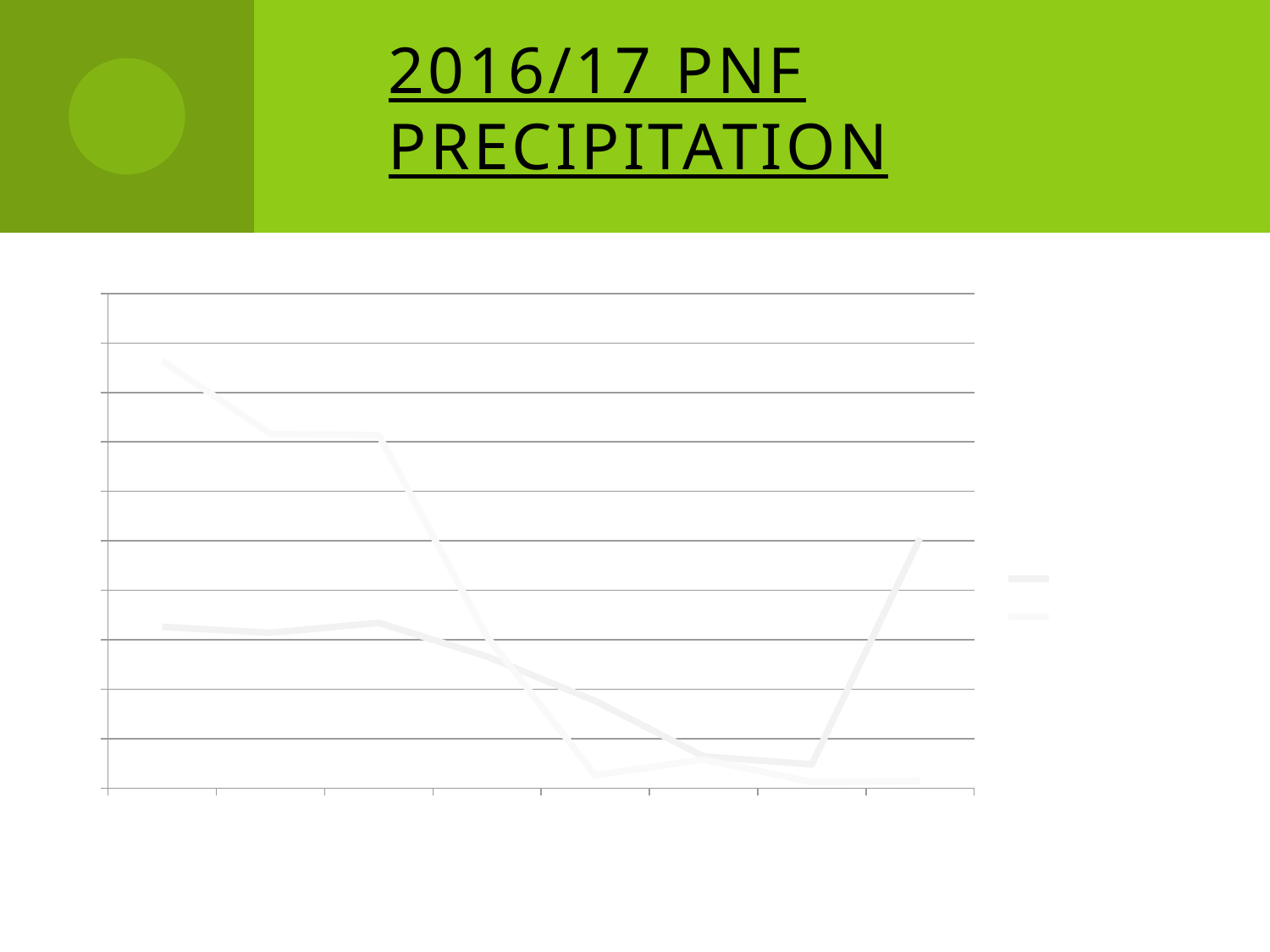
What kind of chart is shown on the slide? line chart How many series does the legend list? 2 What title appears above the chart on the slide? 2016/17 PNF PRECIPITATION How many data points does each line have? 8 Does the line that starts highest at the left generally rise or fall from left to right? fall